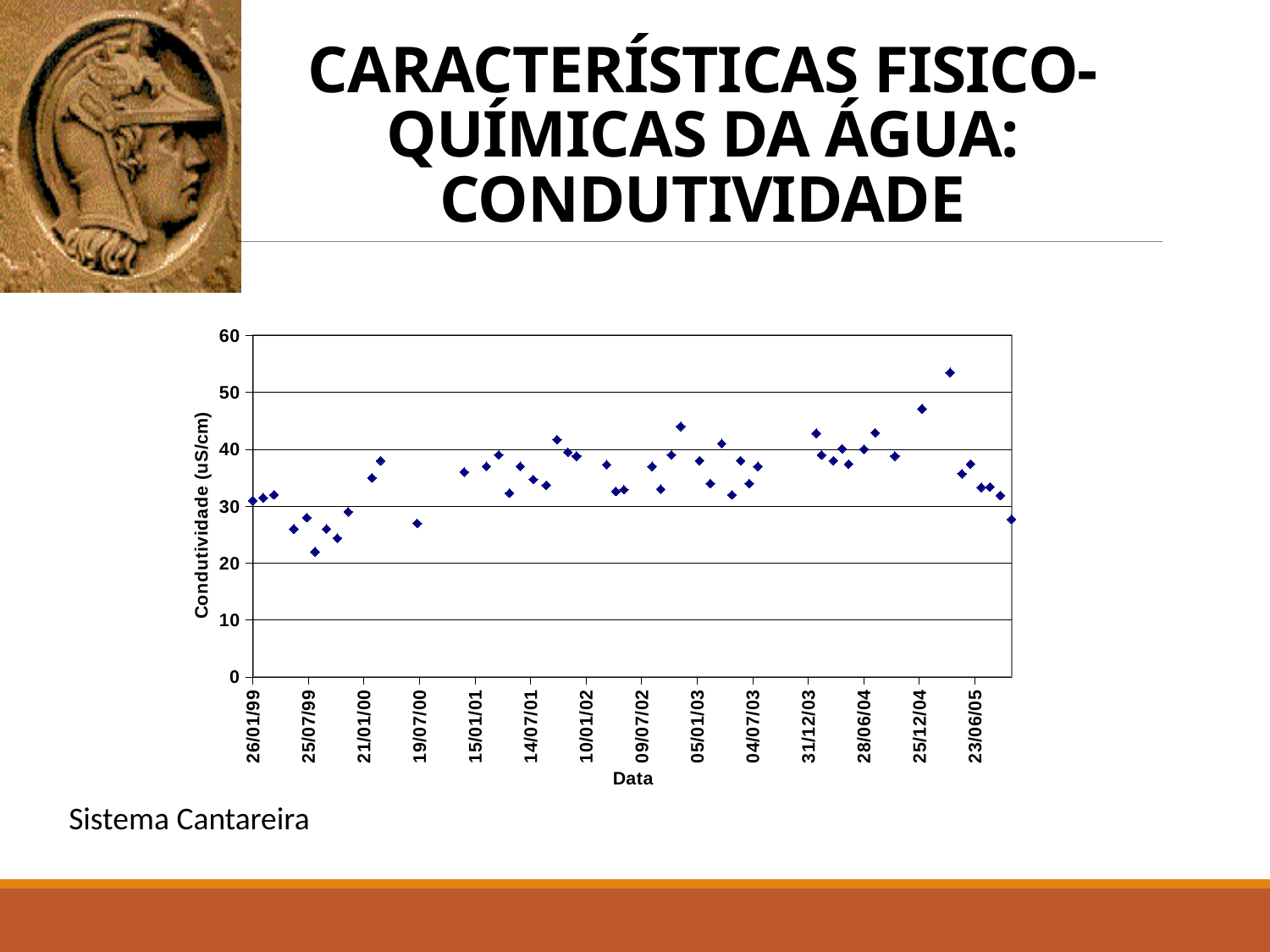
Is the highest plotted conductivity value greater or less than 50? greater Is the lowest plotted conductivity value greater or less than 30? less What is the label of the x axis of the chart? Data Is the value plotted near 19/07/00 greater or less than 30? less What kind of chart is shown on the slide? scatter chart Do the plotted values generally rise or fall between 25/07/99 and 25/12/04? rise How many date labels are shown along the x axis of the chart? 14 What is the label of the y axis of the chart? Condutividade (uS/cm) What is the maximum value shown on the y axis of the chart? 60